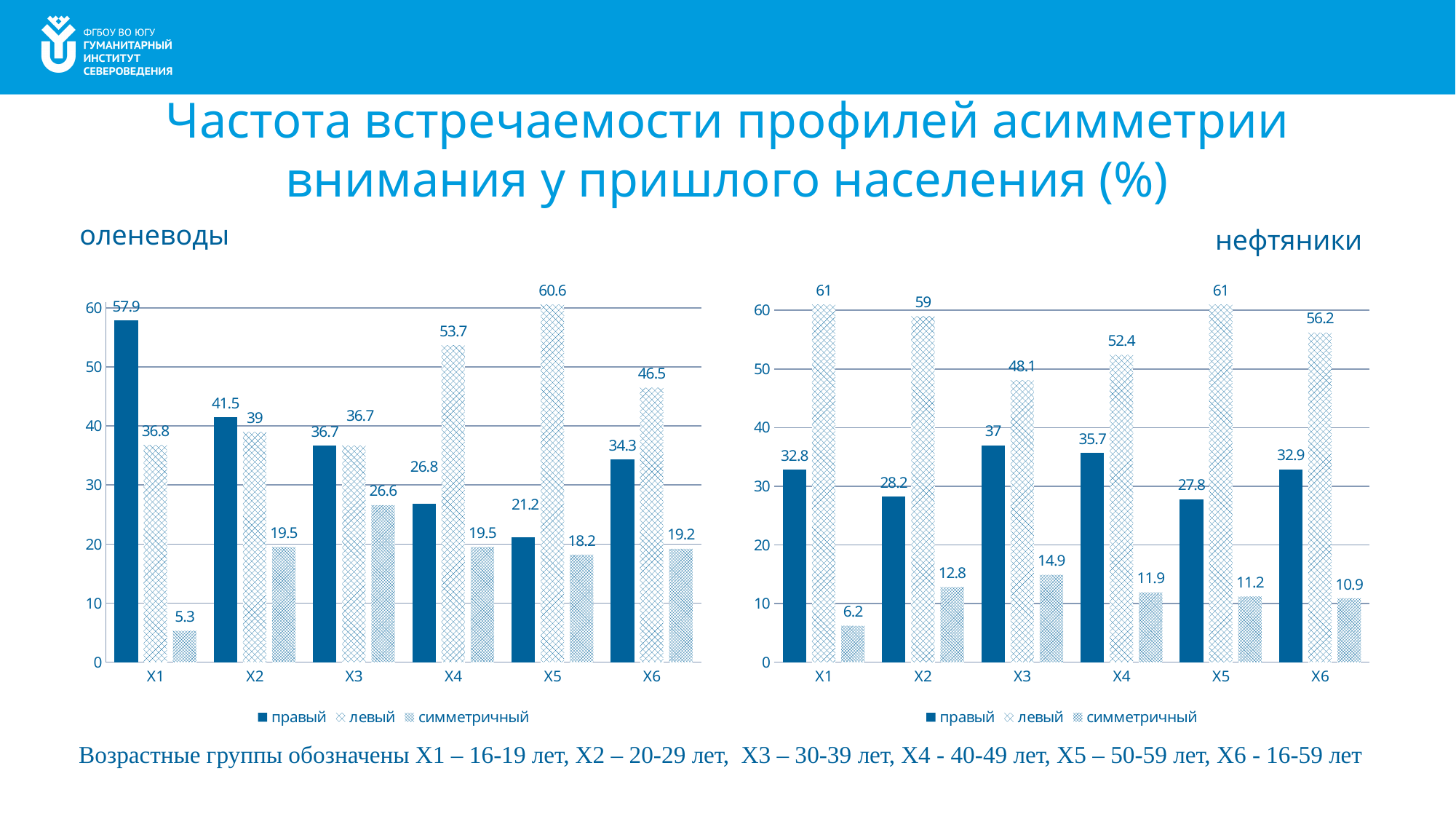
In the left chart (оленеводы), what is the value of правый for X1? 57.9 In the left chart (оленеводы), does the value of правый rise or fall from X1 to X5? fall In the right chart (нефтяники), what is the value of симметричный for X2? 12.8 How many categories are shown on the x axis of the left chart (оленеводы)? 6 How many series does the legend of the right chart (нефтяники) list? 3 In the right chart (нефтяники), which category has the highest value for правый? X3 In the left chart (оленеводы), what is the value of левый for X5? 60.6 In the right chart (нефтяники), is the value of левый for X3 greater or less than 40? greater What type of chart is the left chart (оленеводы)? bar chart In the left chart (оленеводы), which category has the lowest value for симметричный? X1 In the left chart (оленеводы), which is larger for X4: правый or левый? левый In the right chart (нефтяники), what is the difference between левый and правый for X1? 28.2